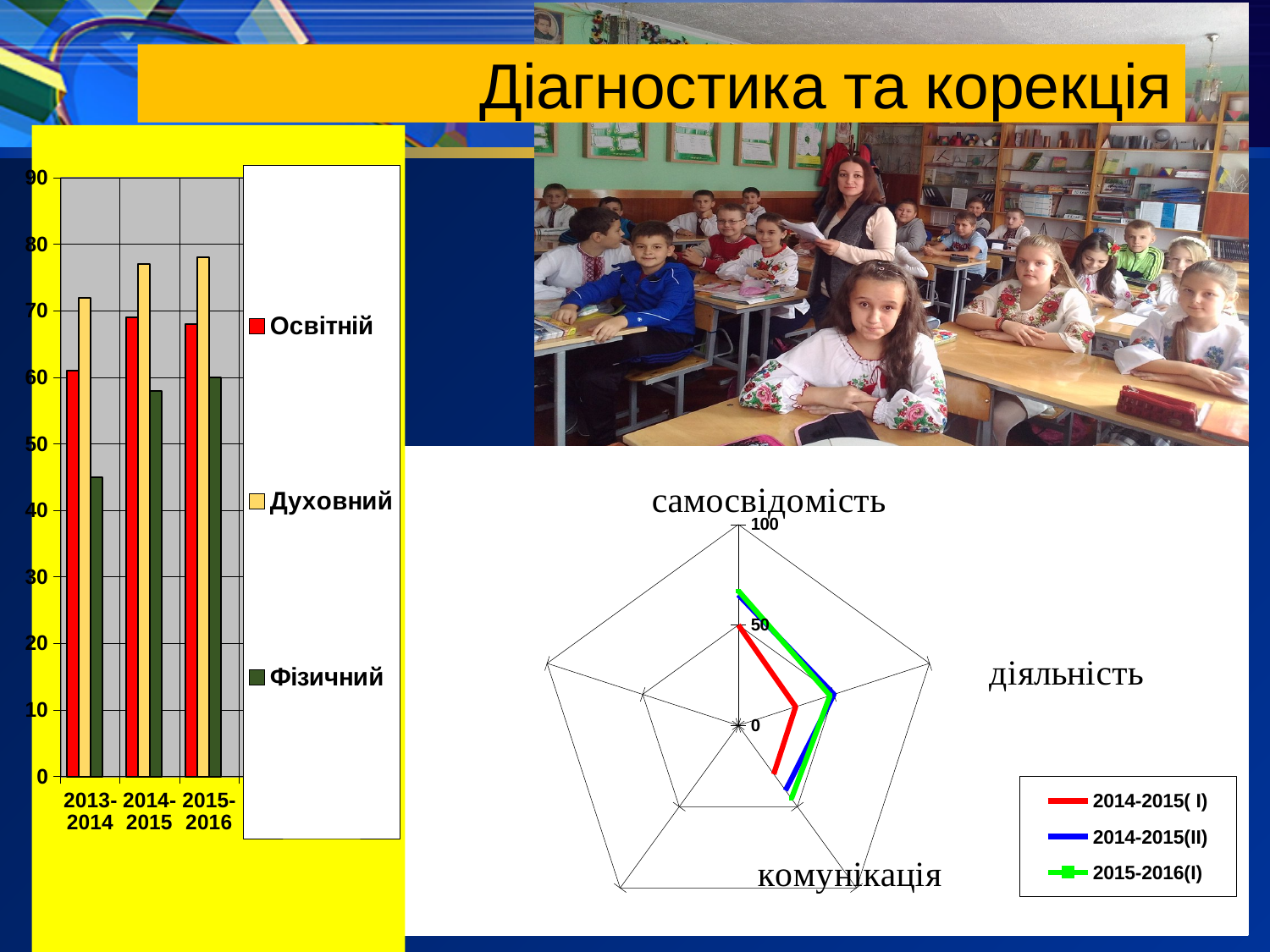
In the bar chart on the left, does the value for Фізичний rise or fall from 2013-2014 to 2015-2016? rise In the bar chart on the left, how many categories are shown on the x axis? 3 In the radar chart on the right, how many series does the legend list? 3 In the bar chart on the left, which series has the highest value in 2014-2015? Духовний In the radar chart on the right, is the value of 2015-2016(I) on the самосвідомість axis greater or less than 50? greater In the bar chart on the left, is the value for Духовний in 2015-2016 greater or less than 80? less What kind of chart is the chart at the bottom right of the slide? radar chart In the bar chart on the left, which series has the lowest value in 2013-2014? Фізичний In the bar chart on the left, is the value for Фізичний in 2015-2016 greater or less than 50? greater In the bar chart on the left, how many series does the legend list? 3 What kind of chart is the chart on the left of the slide? bar chart